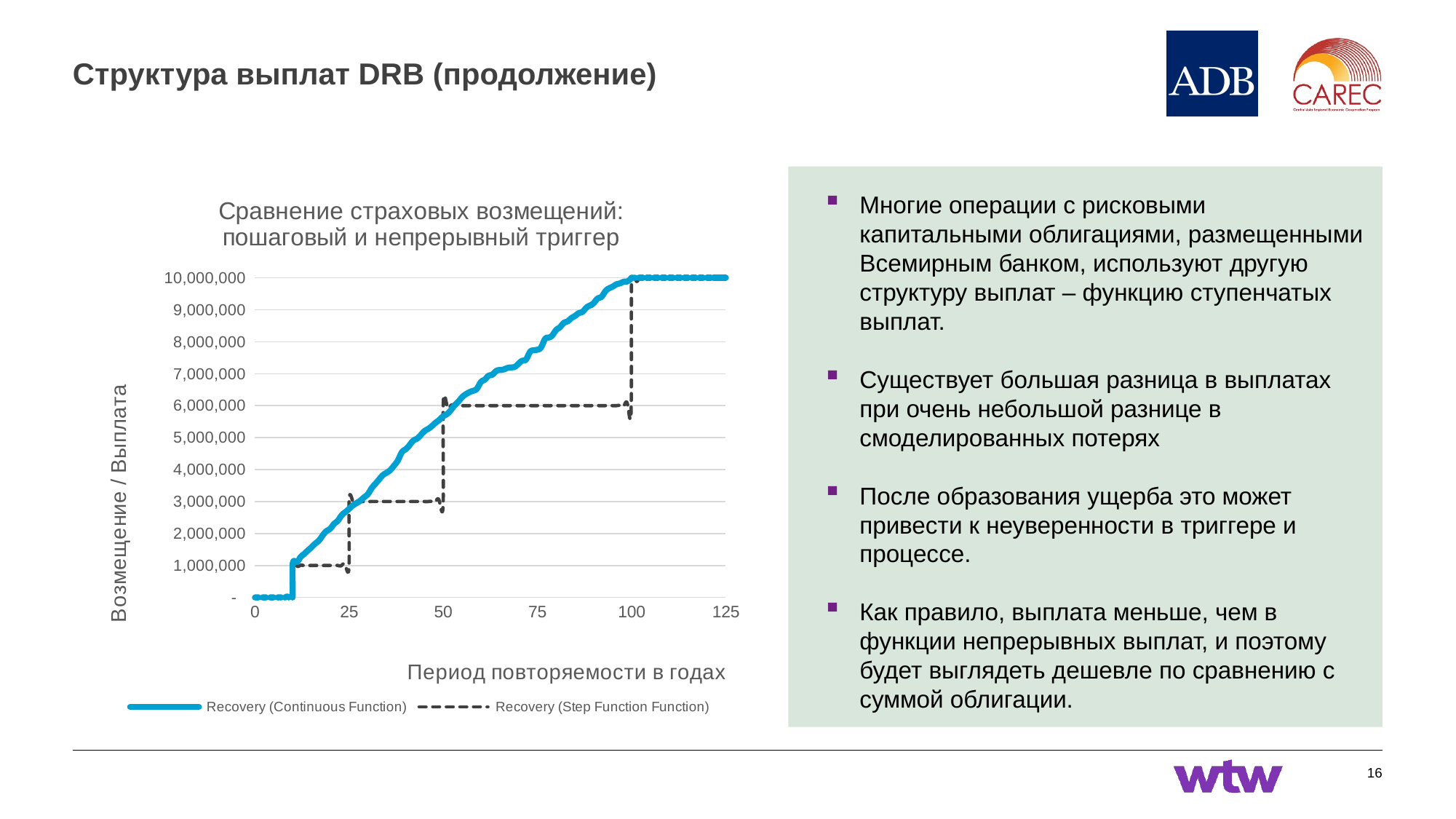
How many tick labels are shown on the x axis of the chart? 6 What value does the Recovery (Step Function Function) series hold between 25 and 50 years on the x axis? 3,000,000 Does the Recovery (Continuous Function) series generally rise or fall as the return period increases from 0 to 100 years? rise At 75 years, which series has the higher value: Recovery (Continuous Function) or Recovery (Step Function Function)? Recovery (Continuous Function) What is the highest value shown on the y axis of the chart? 10,000,000 Is the value of Recovery (Continuous Function) at 75 years greater or less than 7,000,000? greater What kind of chart is shown on the slide? line chart How many series does the chart legend list? 2 What is the label of the x axis of the chart? Период повторяемости в годах What is the title of the chart? Сравнение страховых возмещений: пошаговый и непрерывный триггер What value does the Recovery (Step Function Function) series hold between 50 and 100 years on the x axis? 6,000,000 Is the value of Recovery (Continuous Function) at 60 years greater or less than 6,000,000? greater